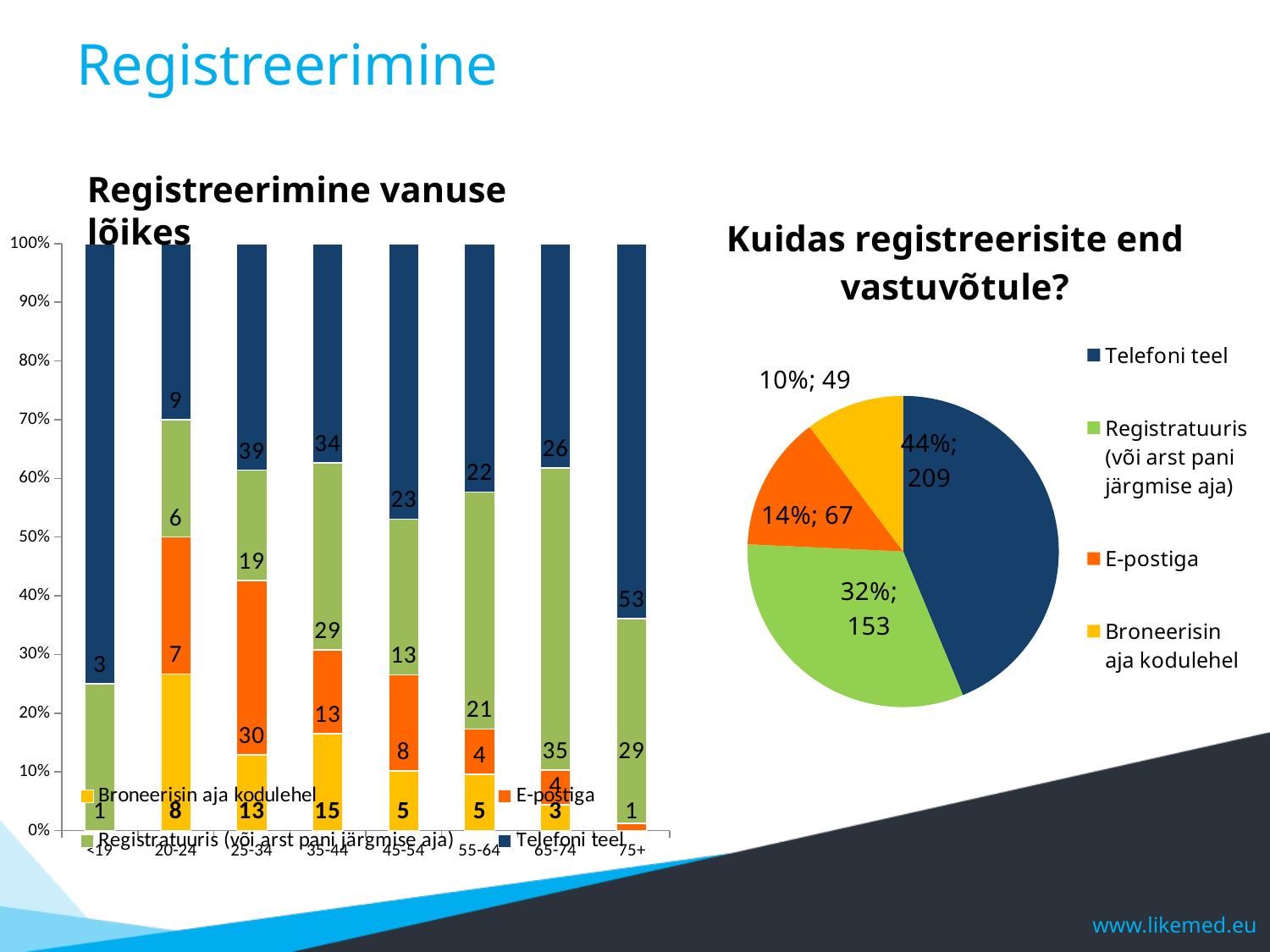
In the chart 'Registreerimine vanuse lõikes', what is the Telefoni teel value for the 75+ age group? 53 In the chart 'Registreerimine vanuse lõikes', is the Telefoni teel share of the 75+ bar greater or less than 50%? greater What type of chart is 'Registreerimine vanuse lõikes'? Stacked bar chart How many age groups are shown on the x axis of the chart 'Registreerimine vanuse lõikes'? 8 In the pie chart 'Kuidas registreerisite end vastuvõtule?', what share of the pie does Registratuuris (või arst pani järgmise aja) take? 32% In the pie chart 'Kuidas registreerisite end vastuvõtule?', which category has the smallest slice? Broneerisin aja kodulehel In the pie chart 'Kuidas registreerisite end vastuvõtule?', which category has the largest slice? Telefoni teel In the pie chart 'Kuidas registreerisite end vastuvõtule?', what value is shown for E-postiga? 14%; 67 How many slices does the pie chart 'Kuidas registreerisite end vastuvõtule?' have? 4 In the pie chart 'Kuidas registreerisite end vastuvõtule?', what value is shown for Telefoni teel? 44%; 209 In the pie chart 'Kuidas registreerisite end vastuvõtule?', how many more responses does Telefoni teel have than Registratuuris (või arst pani järgmise aja)? 56 In the chart 'Registreerimine vanuse lõikes', what is the E-postiga value for the 25-34 age group? 30